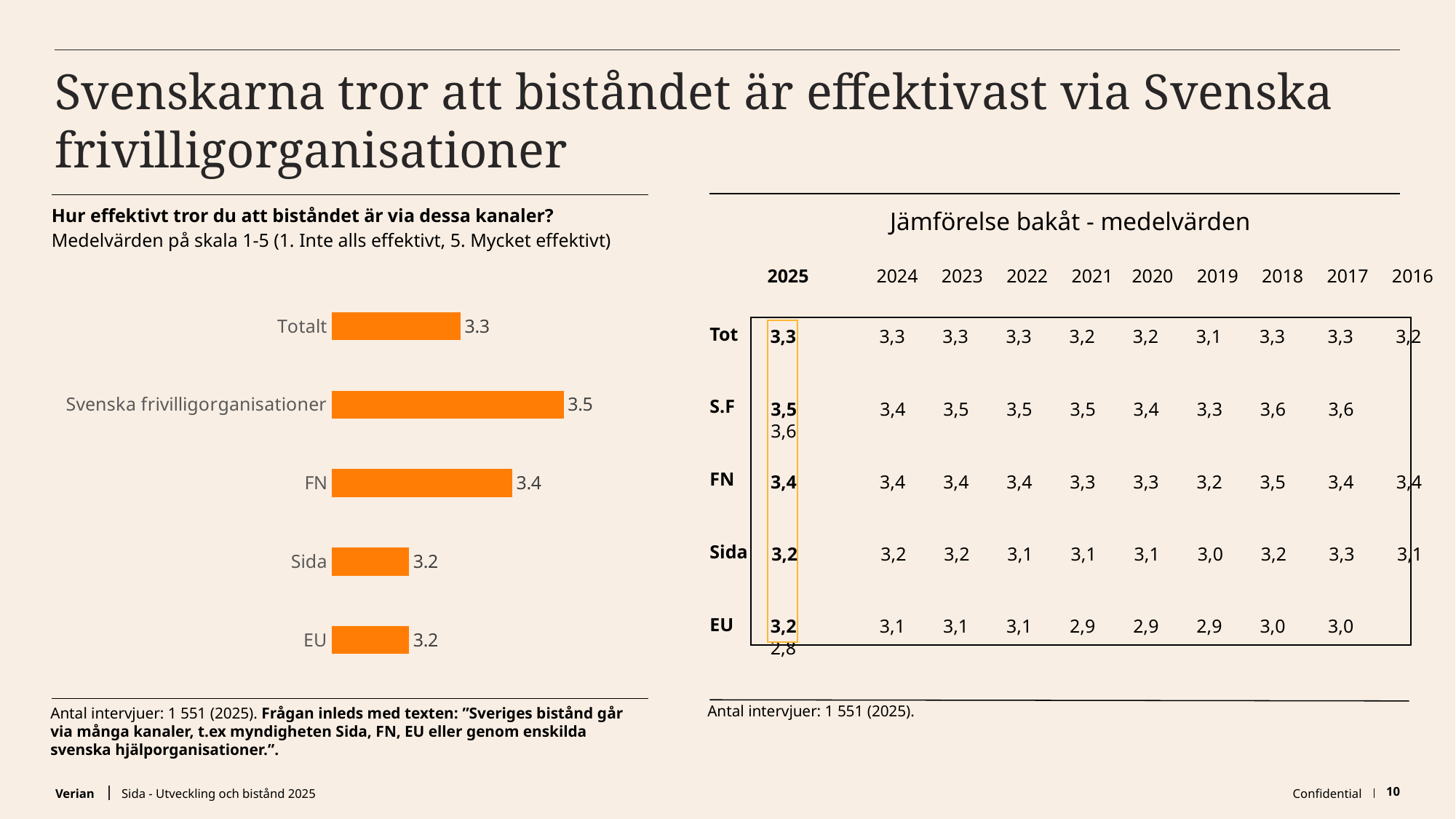
What kind of chart is shown on the left of the slide? Bar chart What is the difference between the values for FN and Totalt in the bar chart? 0.1 What is the value for FN in the bar chart? 3.4 What is the value for Totalt in the bar chart? 3.3 What is the difference between the values for Svenska frivilligorganisationer and Sida in the bar chart? 0.3 Which category has the highest value in the bar chart? Svenska frivilligorganisationer What is the value for Sida in the bar chart? 3.2 What is the value for EU in the bar chart? 3.2 How many categories are shown in the bar chart? 5 What is the value for Svenska frivilligorganisationer in the bar chart? 3.5 In the bar chart, which is larger: the value for FN or the value for EU? FN What colour are the bars in the bar chart? Orange